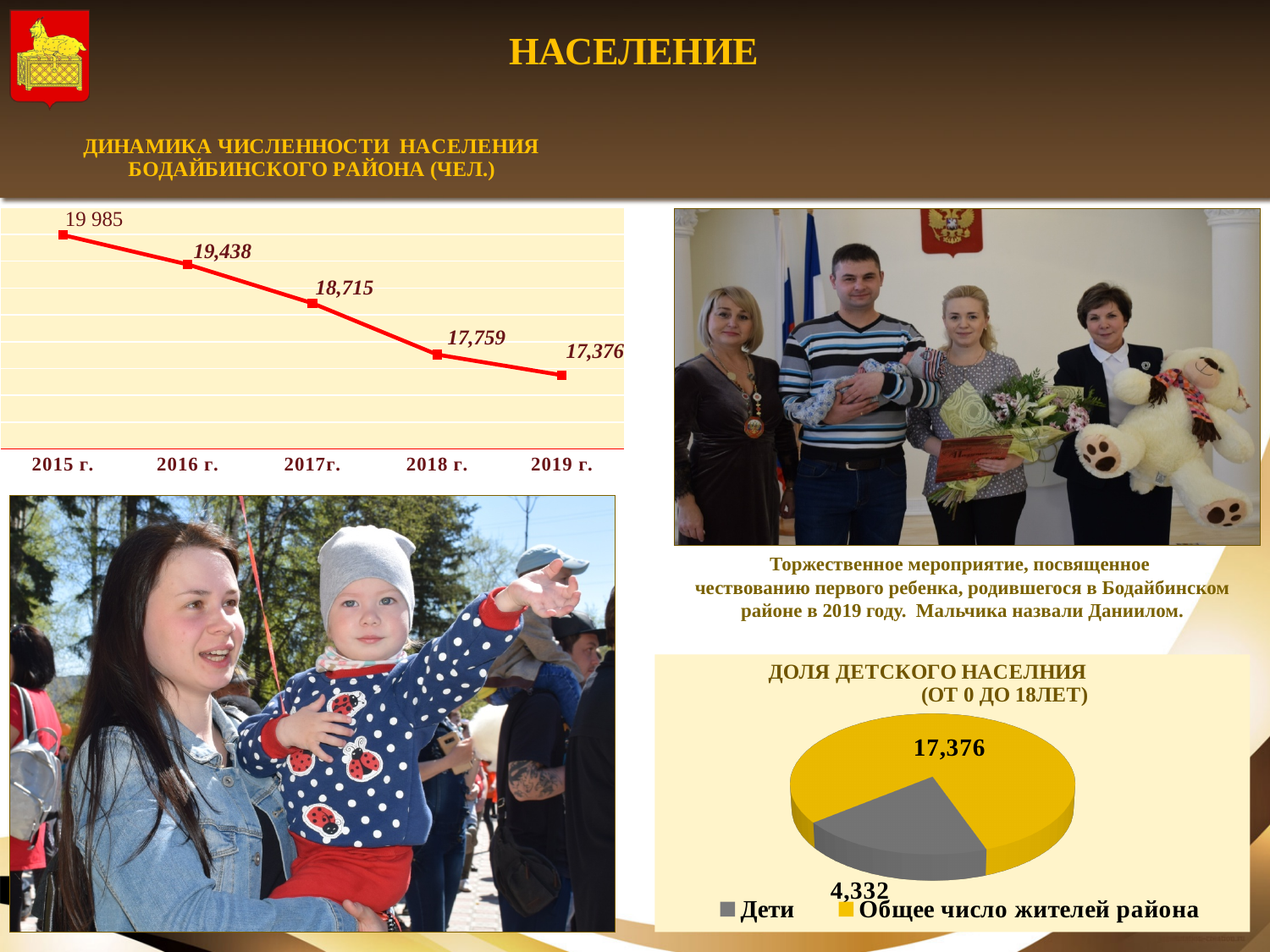
In the line chart 'Динамика численности населения Бодайбинского района', what is the difference between the 2016 г. and 2017г. values? 723 In the line chart 'Динамика численности населения Бодайбинского района', which year has the highest population? 2015 г. In the line chart 'Динамика численности населения Бодайбинского района', what is the population value for 2015 г.? 19 985 What kind of chart is 'Доля детского населния (от 0 до 18лет)'? pie chart In the line chart 'Динамика численности населения Бодайбинского района', do the values rise or fall from 2015 г. to 2019 г.? fall In the line chart 'Динамика численности населения Бодайбинского района', by how much did the population fall from 2015 г. to 2019 г.? 2,609 In the pie chart 'Доля детского населния (от 0 до 18лет)', which slice is larger, 'Дети' or 'Общее число жителей района'? Общее число жителей района In the line chart 'Динамика численности населения Бодайбинского района', what is the population value for 2019 г.? 17,376 In the line chart 'Динамика численности населения Бодайбинского района', what is the population value for 2017г.? 18,715 How many years are plotted in the line chart 'Динамика численности населения Бодайбинского района'? 5 In the line chart 'Динамика численности населения Бодайбинского района', which year has the lowest population? 2019 г. In the pie chart 'Доля детского населния (от 0 до 18лет)', what is the value for 'Дети'? 4,332